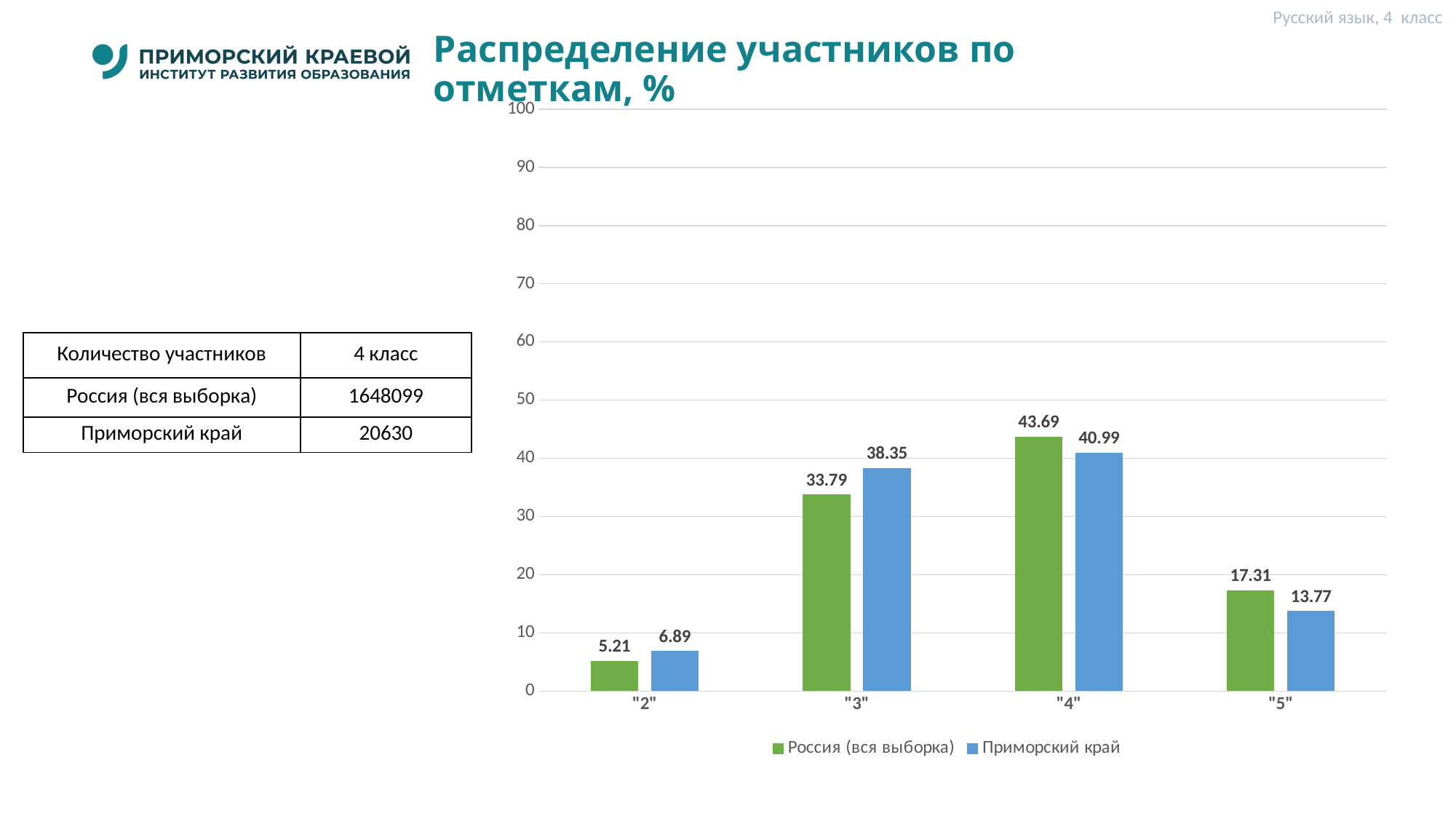
What is the value for Россия (вся выборка) for mark "3"? 33.79 Which mark has the highest value for Россия (вся выборка)? "4" What kind of chart is shown on the slide? bar chart Which mark has the lowest value for Приморский край? "2" What is the value for Приморский край for mark "4"? 40.99 What is the title of the chart? Распределение участников по отметкам, % What is the difference between Россия (вся выборка) and Приморский край for mark "5"? 3.54 Is the value for Приморский край for mark "3" greater or less than 30? greater How many mark categories are shown on the x axis? 4 How many series does the legend list? 2 What is the value for Приморский край for mark "2"? 6.89 For mark "3", which series has the larger value: Россия (вся выборка) or Приморский край? Приморский край